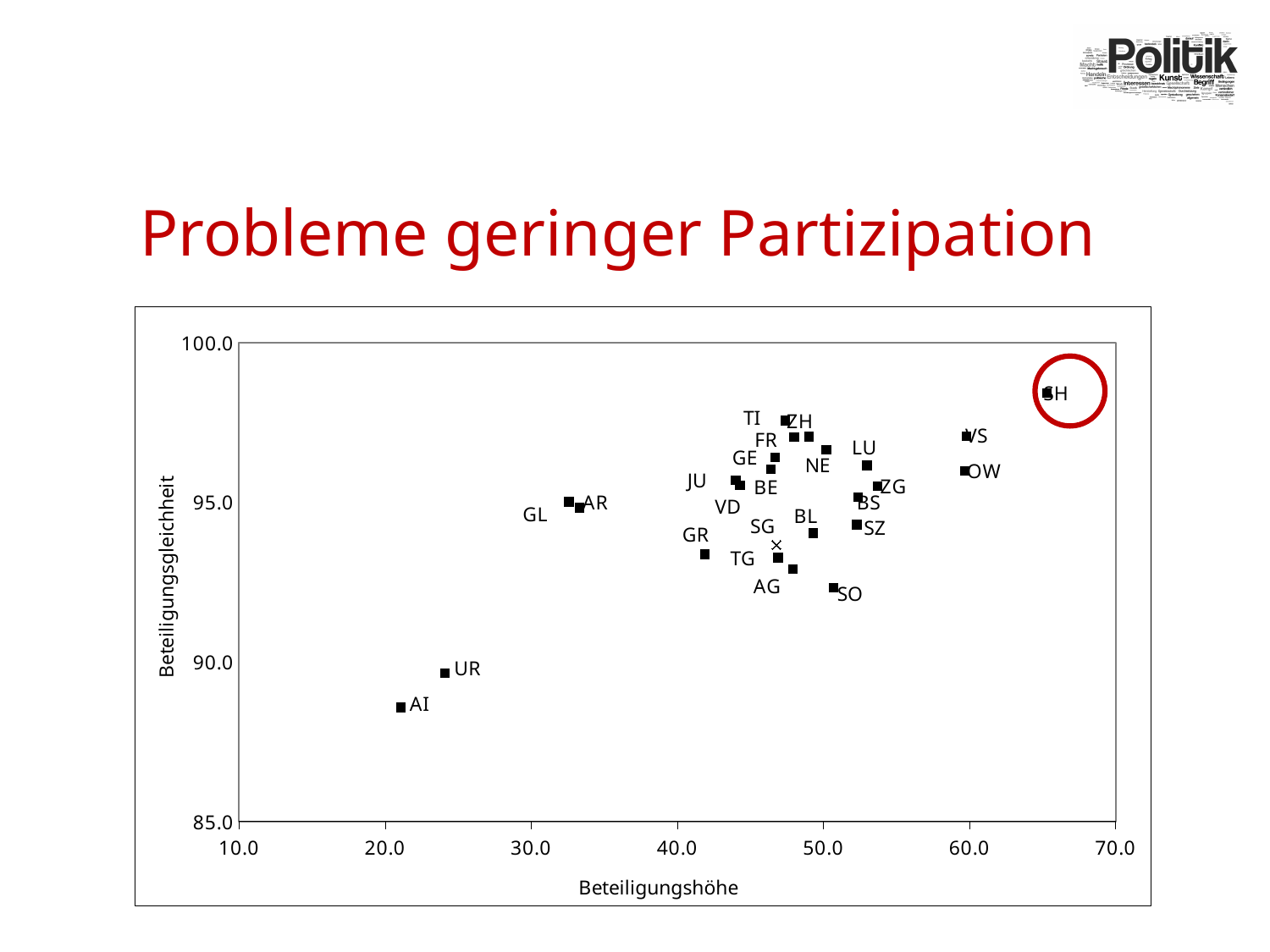
What is the label of the x axis of the chart? Beteiligungshöhe Which canton's point is circled in red on the chart? SH Which canton has the lowest Beteiligungsgleichheit? AI Is the Beteiligungshöhe value for UR greater or less than 30.0? less Which canton has the lowest Beteiligungshöhe? AI What kind of chart is shown on the slide? scatter plot Is the Beteiligungsgleichheit value for SO greater or less than 95.0? less Is the Beteiligungshöhe value for SH greater or less than 60.0? greater Which canton has the highest Beteiligungshöhe? SH Do the Beteiligungsgleichheit values generally rise or fall as Beteiligungshöhe increases along the x axis? rise Which has the higher Beteiligungsgleichheit, UR or AI? UR